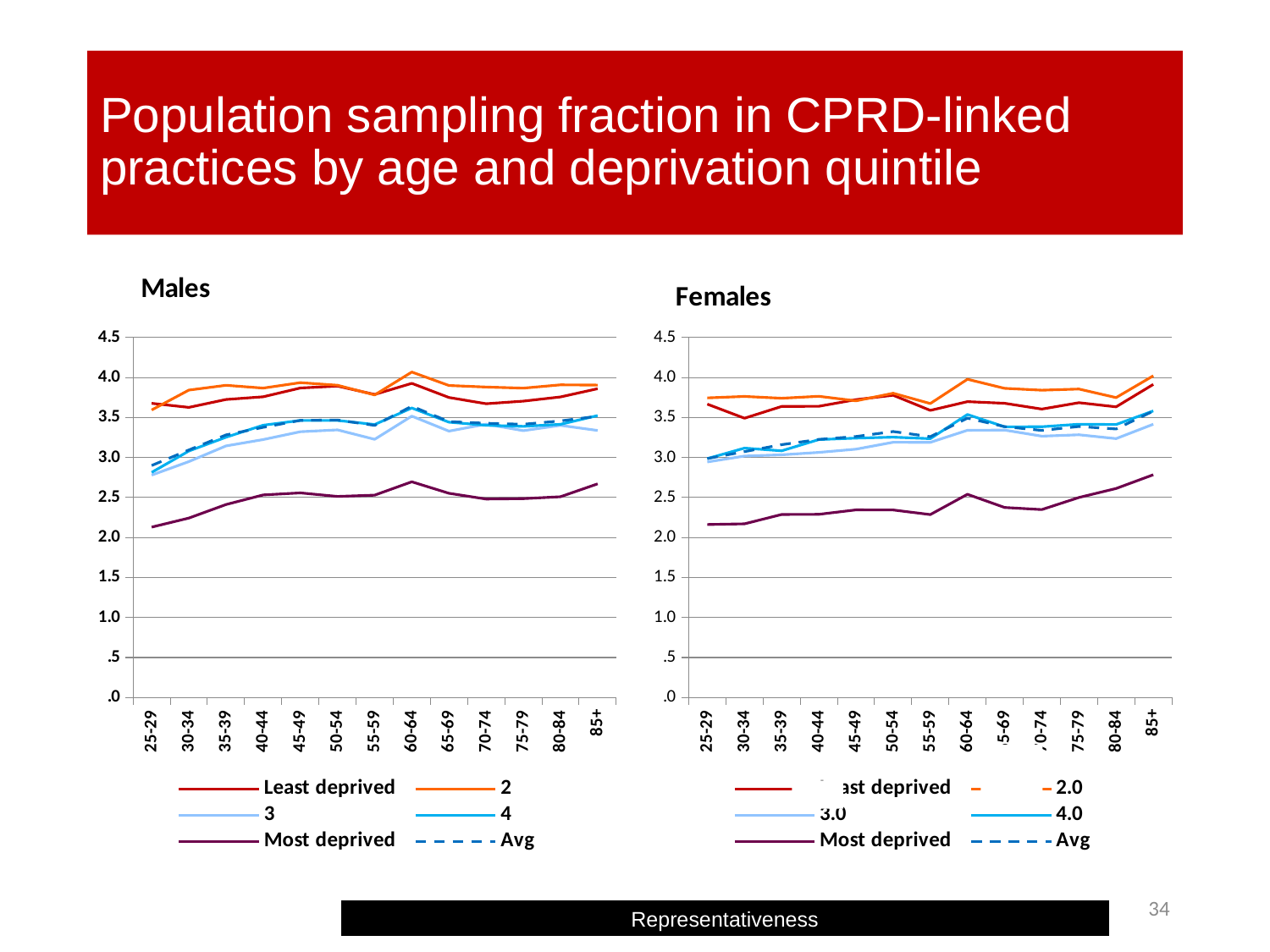
What kind of chart is the Males chart? line chart In the Males chart, which series has the lowest values across all age groups? Most deprived In the Males chart, is the value for Most deprived at 25-29 greater or less than 2.5? less In the Females chart, does the Most deprived line generally rise or fall from 25-29 to 85+? rise In the Females chart, is the value for Most deprived at 85+ greater or less than 3.0? less In the Males chart, which is larger at 25-29: the value for Least deprived or the value for Most deprived? Least deprived How many series does the legend of the Males chart list? 6 Which series in the Males chart is drawn with a dashed line? Avg In the Males chart, is the value for 2 at 60-64 greater or less than 4.0? greater How many age groups are shown on the x axis of the Females chart? 13 In the Females chart, which series has the lowest values across all age groups? Most deprived